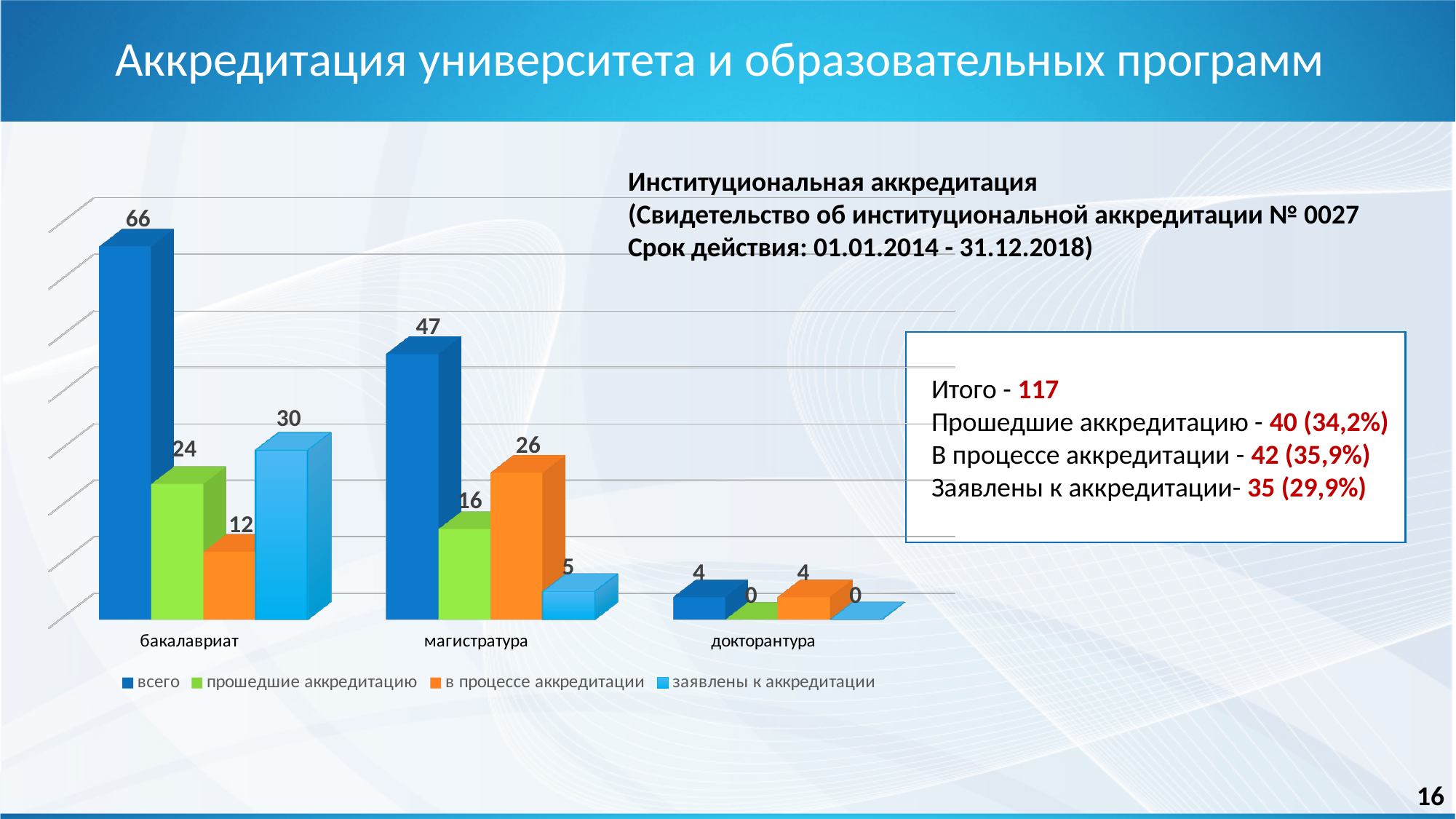
What is the value of 'заявлены к аккредитации' for докторантура? 0 Which category has the lowest value for 'прошедшие аккредитацию'? докторантура Which category has the highest value for 'всего'? бакалавриат What is the value of 'в процессе аккредитации' for магистратура? 26 How many categories are shown on the x axis? 3 Which colour represents the series 'в процессе аккредитации' in the legend? orange What kind of chart is shown on the slide? bar chart What is the difference between 'всего' for бакалавриат and 'всего' for магистратура? 19 Do the values for 'всего' rise or fall from бакалавриат to докторантура? fall Which is larger for бакалавриат: 'прошедшие аккредитацию' or 'заявлены к аккредитации'? заявлены к аккредитации How many series does the legend list? 4 What is the value of 'всего' for бакалавриат? 66